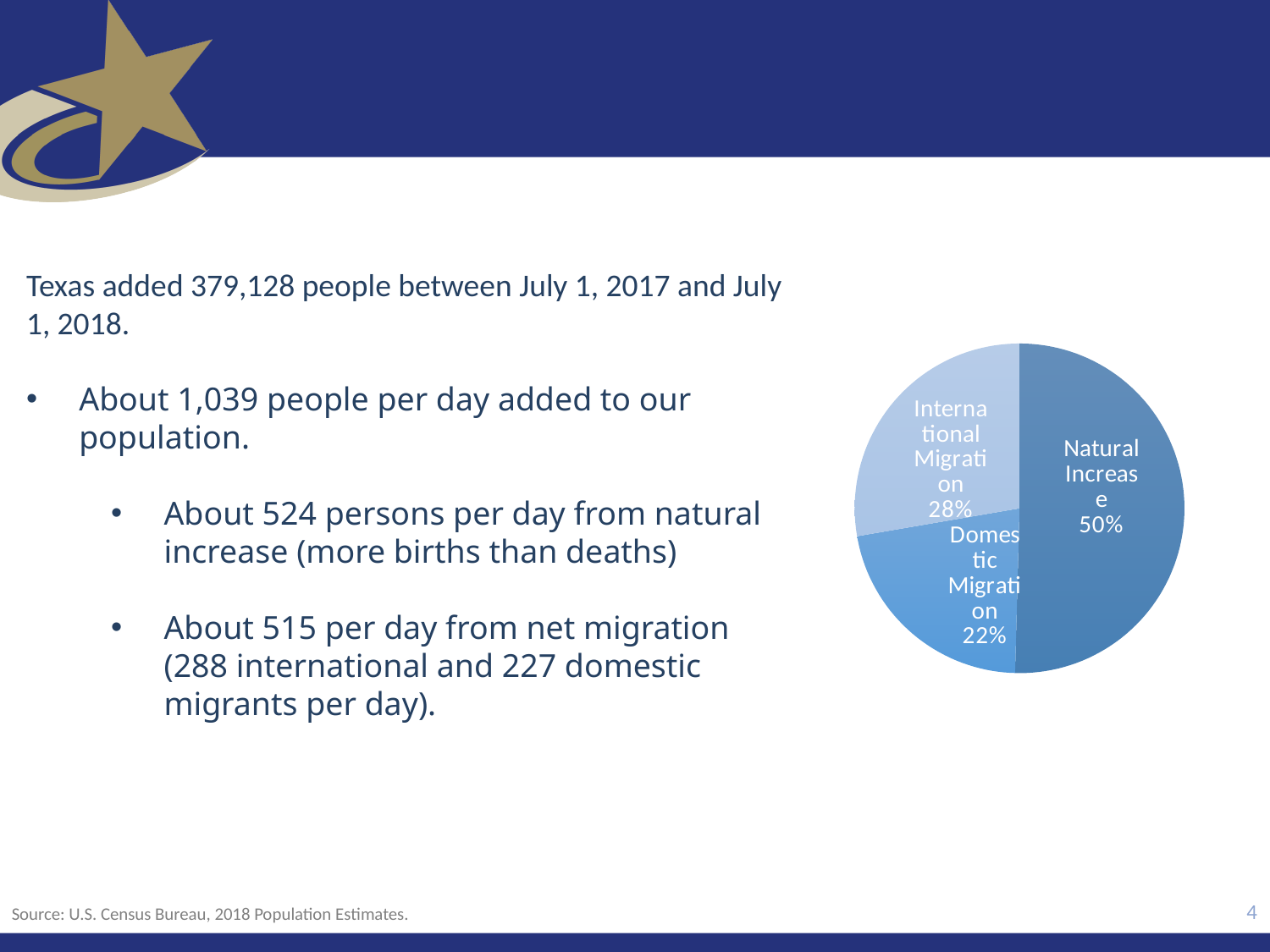
What is the combined share of the International Migration and Domestic Migration slices? 50% Which slice of the pie chart is the largest? Natural Increase Which is larger, the International Migration slice or the Domestic Migration slice? International Migration Which slice of the pie chart is the smallest? Domestic Migration What share of the pie does Domestic Migration represent? 22% What is the difference in percentage points between the Natural Increase slice and the International Migration slice? 22 Which slice of the pie chart is shown in the darkest blue? Natural Increase What kind of chart is shown on the slide? pie chart How many slices does the pie chart have? 3 What is the difference in percentage points between the International Migration slice and the Domestic Migration slice? 6 What share of the pie does International Migration represent? 28% What share of the pie does Natural Increase represent? 50%